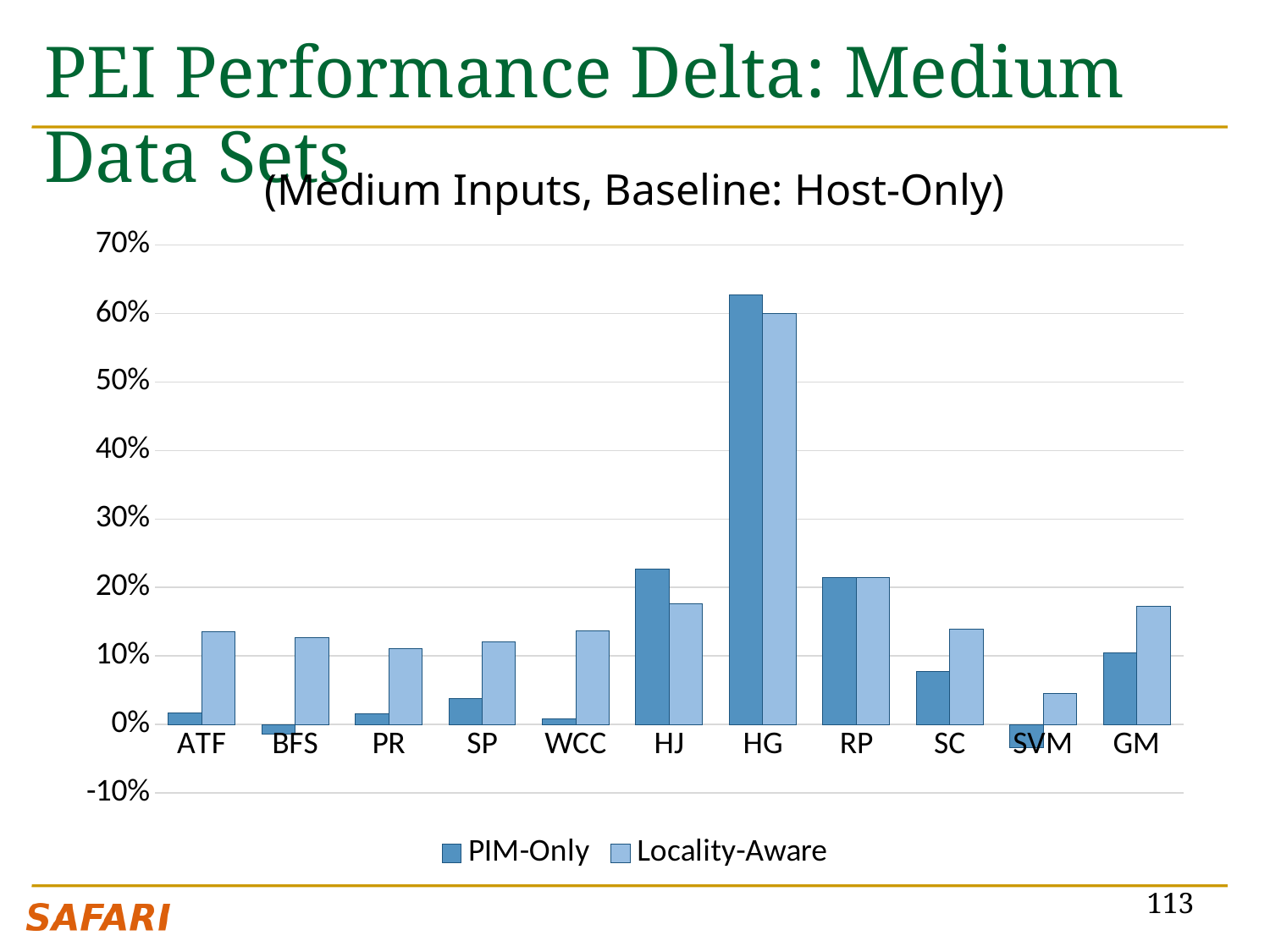
For ATF, which is larger: the PIM-Only value or the Locality-Aware value? Locality-Aware Is the PIM-Only value for HJ greater or less than 20%? greater How many series does the legend list? 2 Is the PIM-Only value for HG greater or less than 60%? greater Is the Locality-Aware value for GM greater or less than 10%? greater Which category has the highest PIM-Only value? HG What is the chart's title? (Medium Inputs, Baseline: Host-Only) Which category has the highest Locality-Aware value? HG What kind of chart is shown on the slide? bar chart For HJ, which is larger: the PIM-Only value or the Locality-Aware value? PIM-Only How many categories are shown on the x axis? 11 Which category has the lowest Locality-Aware value? SVM